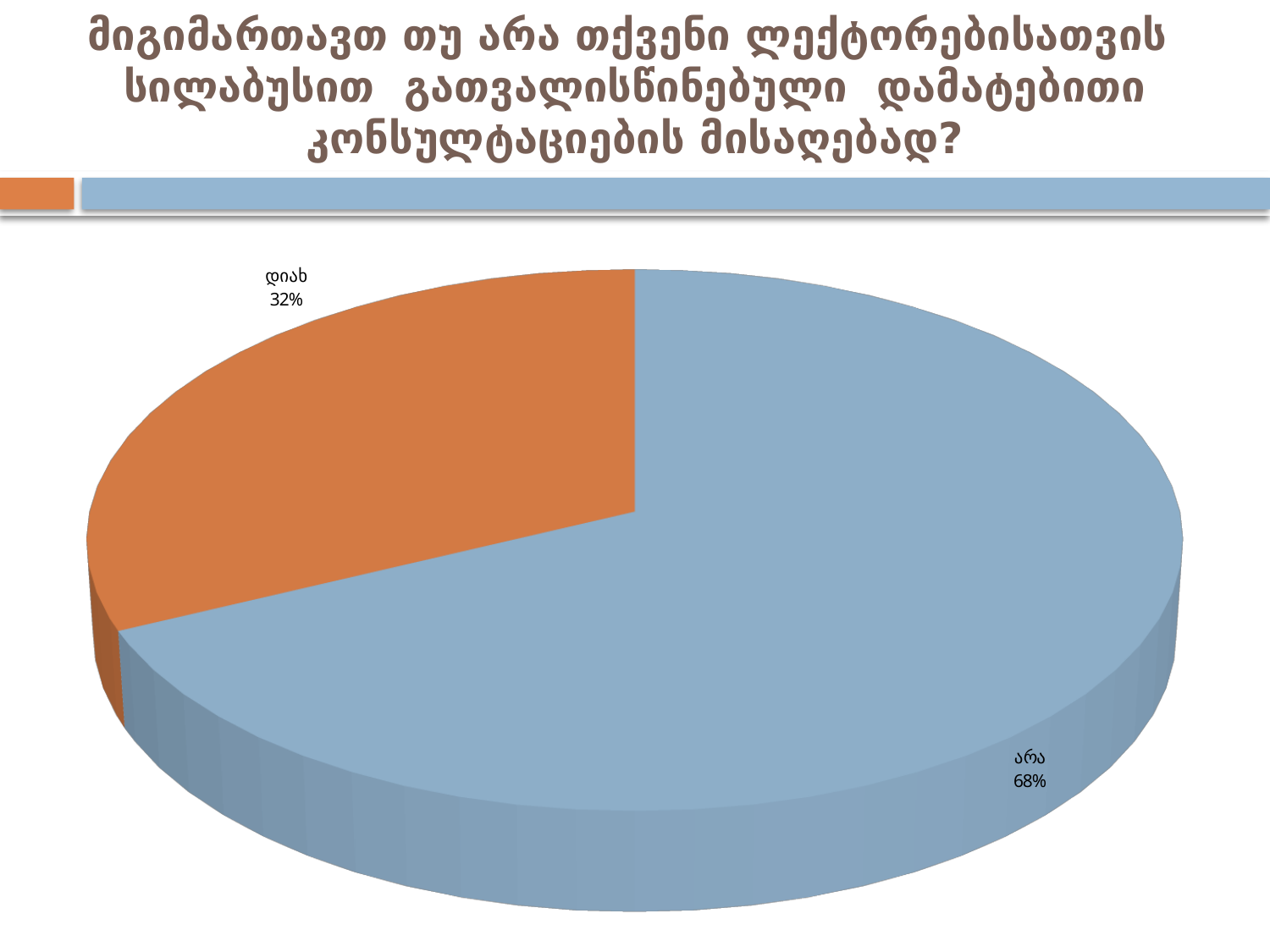
What share of the pie does the "არა" slice represent? 68% What percentage of the pie chart is labelled "არა"? 68% What colour is the "დიახ" slice of the pie chart? Orange What colour is the "არა" slice of the pie chart? Blue Which is larger: the "დიახ" slice or the "არა" slice? არა What is the difference in percentage points between the "არა" slice and the "დიახ" slice? 36 Which slice of the pie chart is the largest? არა How many slices does the pie chart have? 2 What percentage of the pie chart is labelled "დიახ"? 32% Is the share for "დიახ" greater or less than 50%? less Which slice of the pie chart is the smallest? დიახ What kind of chart is shown on the slide? Pie chart